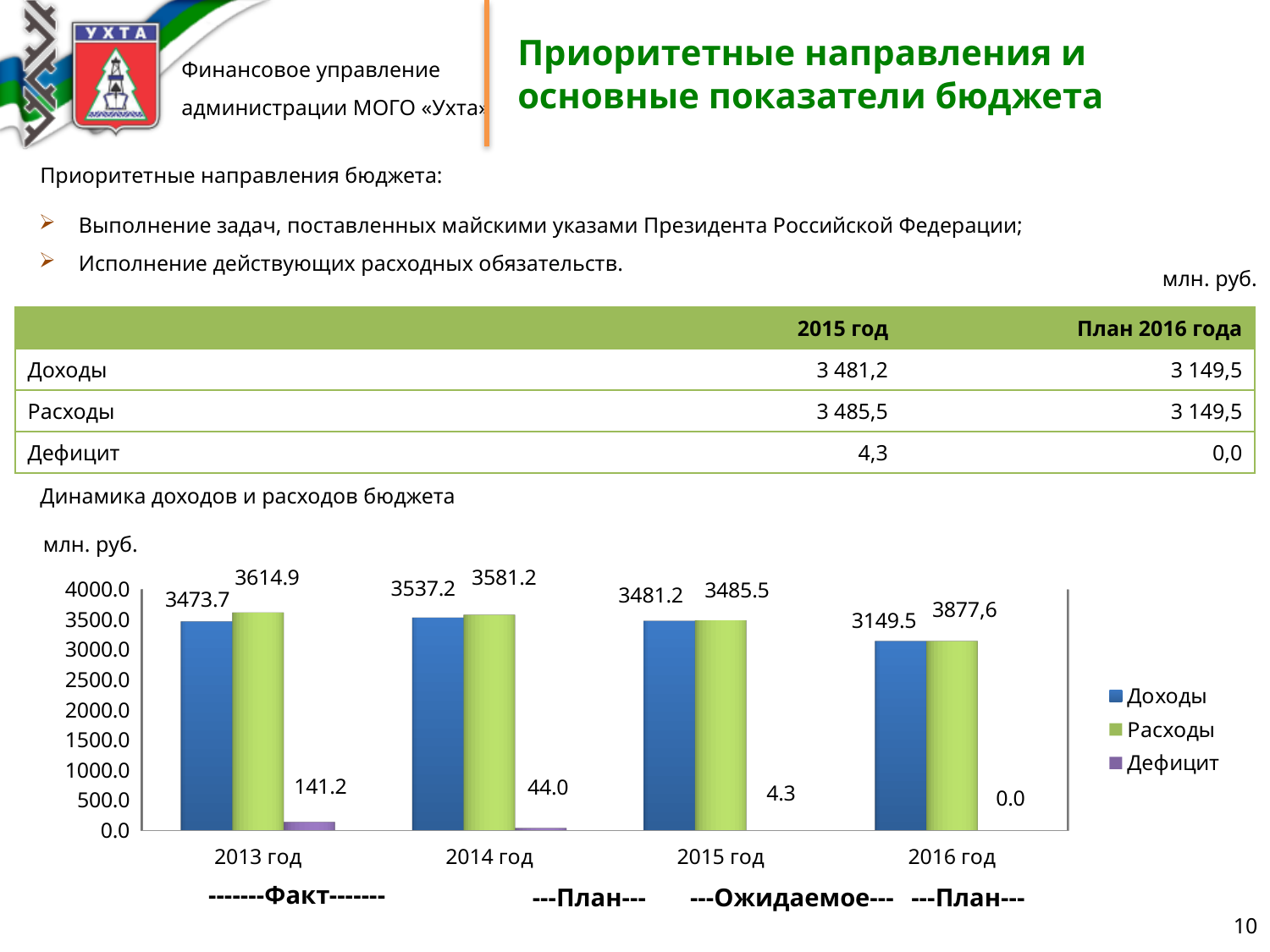
By how much do Расходы exceed Доходы in 2013 год according to the chart labels? 141.2 How many series does the chart legend list? 3 What is the value of Дефицит for 2013 год in the chart? 141.2 What is the value of Дефицит for 2015 год in the chart? 4.3 In which year is Доходы lowest in the chart? 2016 год In which year is Доходы highest in the chart? 2014 год Which series are listed in the chart legend? Доходы, Расходы, Дефицит What kind of chart is shown under "Динамика доходов и расходов бюджета"? bar chart What is the value of Расходы for 2014 год in the chart? 3581.2 Does the Дефицит series rise or fall from 2013 год to 2016 год? fall What is the value of Доходы for 2013 год in the chart? 3473.7 How many year categories are shown on the x axis of the chart? 4